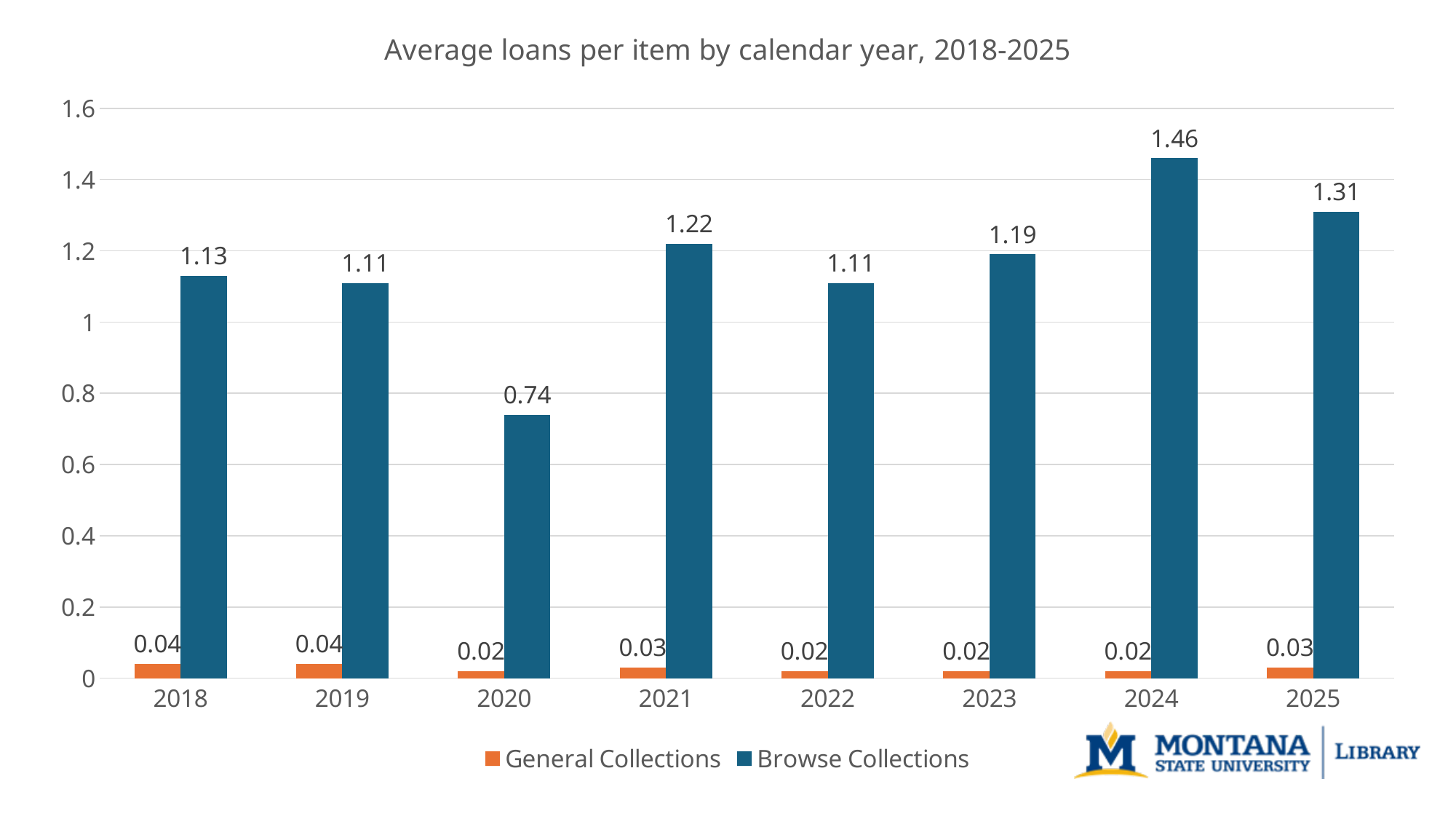
Is the Browse Collections value for 2025 greater or less than 1.2? greater Which year has the highest value for Browse Collections? 2024 How many years are shown on the x axis? 8 What is the value for General Collections in 2021? 0.03 Which year has the lowest value for Browse Collections? 2020 What kind of chart is shown on the slide? Bar chart What is the value for Browse Collections in 2024? 1.46 What is the difference between the Browse Collections values for 2021 and 2020? 0.48 What is the difference between the Browse Collections values for 2024 and 2025? 0.15 Which is larger, the Browse Collections value for 2018 or for 2023? 2023 How many series does the legend list? 2 What is the value for Browse Collections in 2020? 0.74